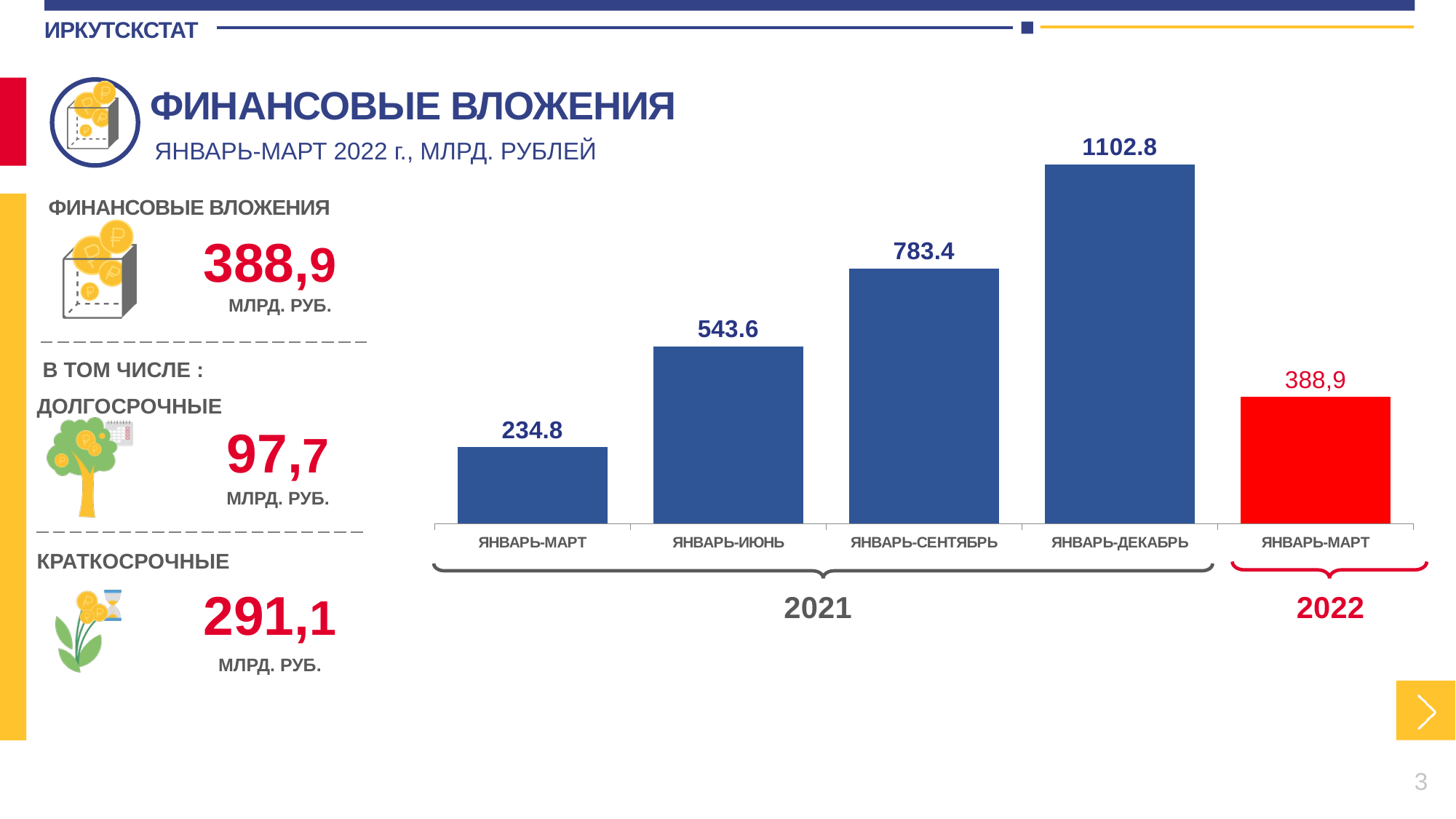
What type of chart is shown on the slide? Bar chart What is the value of the red bar for Январь-Март 2022? 388,9 How many bars are shown in the chart? 5 What is the difference between the values for Январь-Декабрь 2021 and Январь-Сентябрь 2021? 319.4 Which period has the highest bar in the chart? Январь-Декабрь 2021 Which period has the lowest bar in the chart? Январь-Март 2021 What is the value of the bar for Январь-Март 2021? 234.8 What is the value of the bar for Январь-Июнь 2021? 543.6 Which is larger: the value for Январь-Март 2022 or the value for Январь-Март 2021? Январь-Март 2022 What is the value of the bar for Январь-Сентябрь 2021? 783.4 What is the value of the bar for Январь-Декабрь 2021? 1102.8 Do the values rise or fall across the four 2021 periods from Январь-Март to Январь-Декабрь? Rise